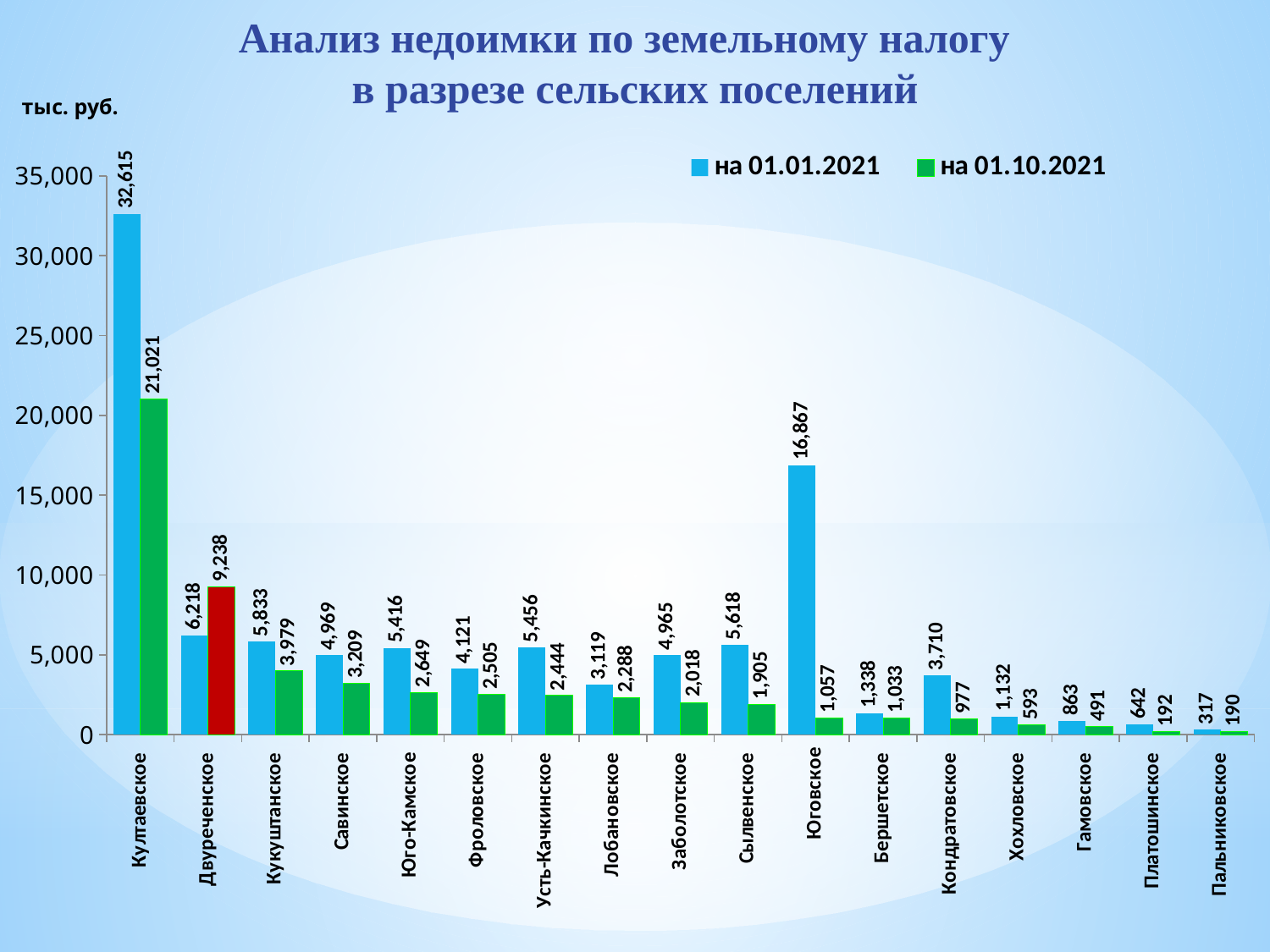
Which is larger for Сылвенское: the value на 01.01.2021 or the value на 01.10.2021? на 01.01.2021 What is the difference between the на 01.10.2021 and на 01.01.2021 values for Двуреченское? 3,020 How many series does the legend list? 2 Which category has the lowest value in the series на 01.01.2021? Пальниковское What is the value for Двуреченское in the series на 01.10.2021? 9,238 What kind of chart is shown on the slide? Bar chart How many categories (settlements) are shown on the x axis? 17 What unit of measurement is indicated for the values on the chart? тыс. руб. What is the value for Юговское in the series на 01.01.2021? 16,867 Which category has the highest value in the series на 01.10.2021? Култаевское What is the difference between the на 01.01.2021 and на 01.10.2021 values for Юговское? 15,810 What is the value for Култаевское in the series на 01.01.2021? 32,615